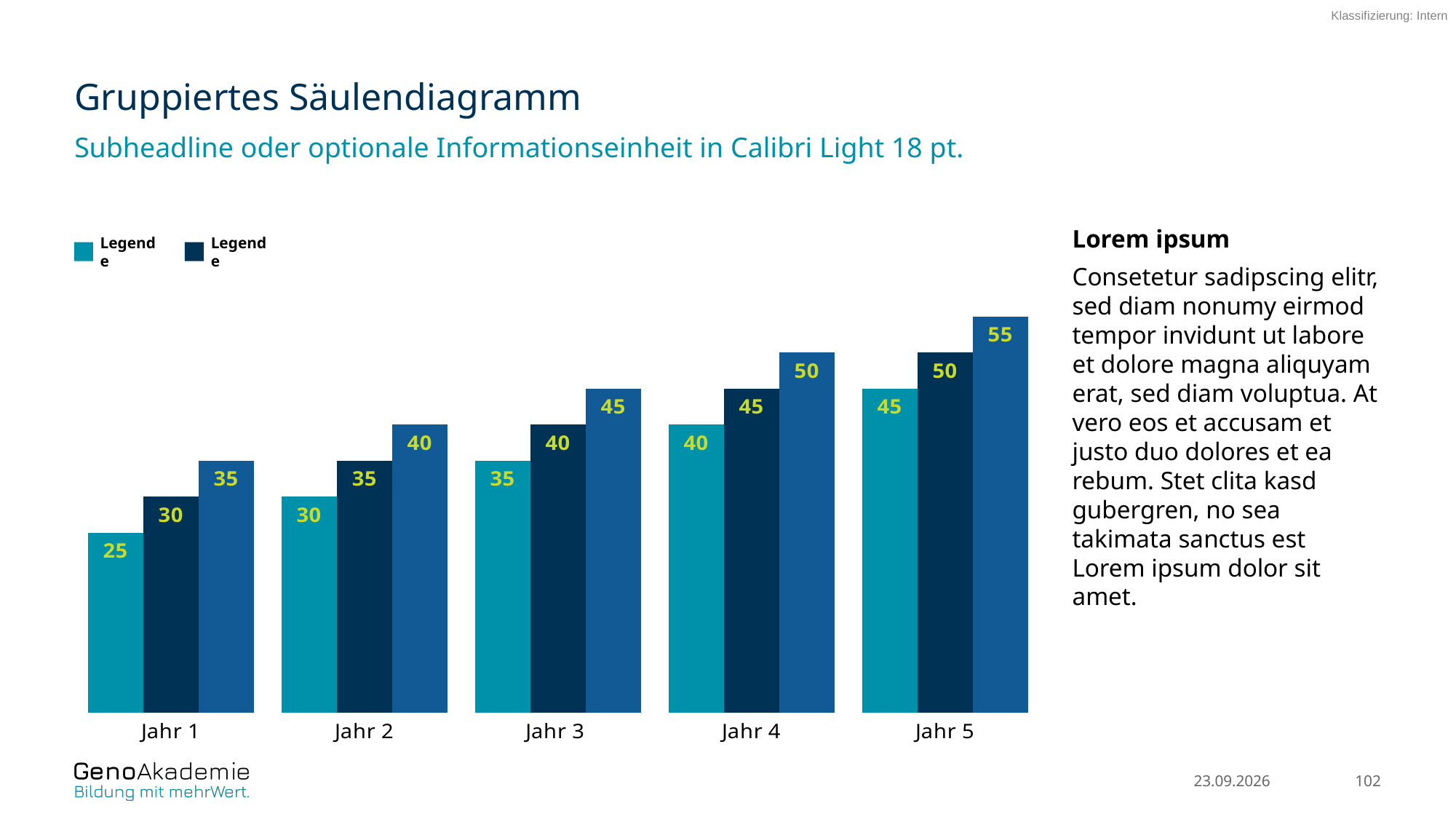
What is the value of the teal (leftmost) bar for Jahr 4? 40 What is the value of the teal (leftmost) bar for Jahr 1? 25 Do the values of the teal bars rise or fall from Jahr 1 to Jahr 5? Rise What is the value of the dark navy (middle) bar for Jahr 3? 40 Which is larger: the dark navy bar for Jahr 2 or the teal bar for Jahr 4? The teal bar for Jahr 4 Which year has the highest bar in the chart? Jahr 5 Which year has the lowest bar in the chart? Jahr 1 How many entries does the chart's legend list? 2 What is the difference between the medium blue bar for Jahr 5 and the teal bar for Jahr 1? 30 What type of chart is shown on the slide? Bar chart How many categories (years) are shown on the x axis of the chart? 5 What is the value of the medium blue (rightmost) bar for Jahr 5? 55